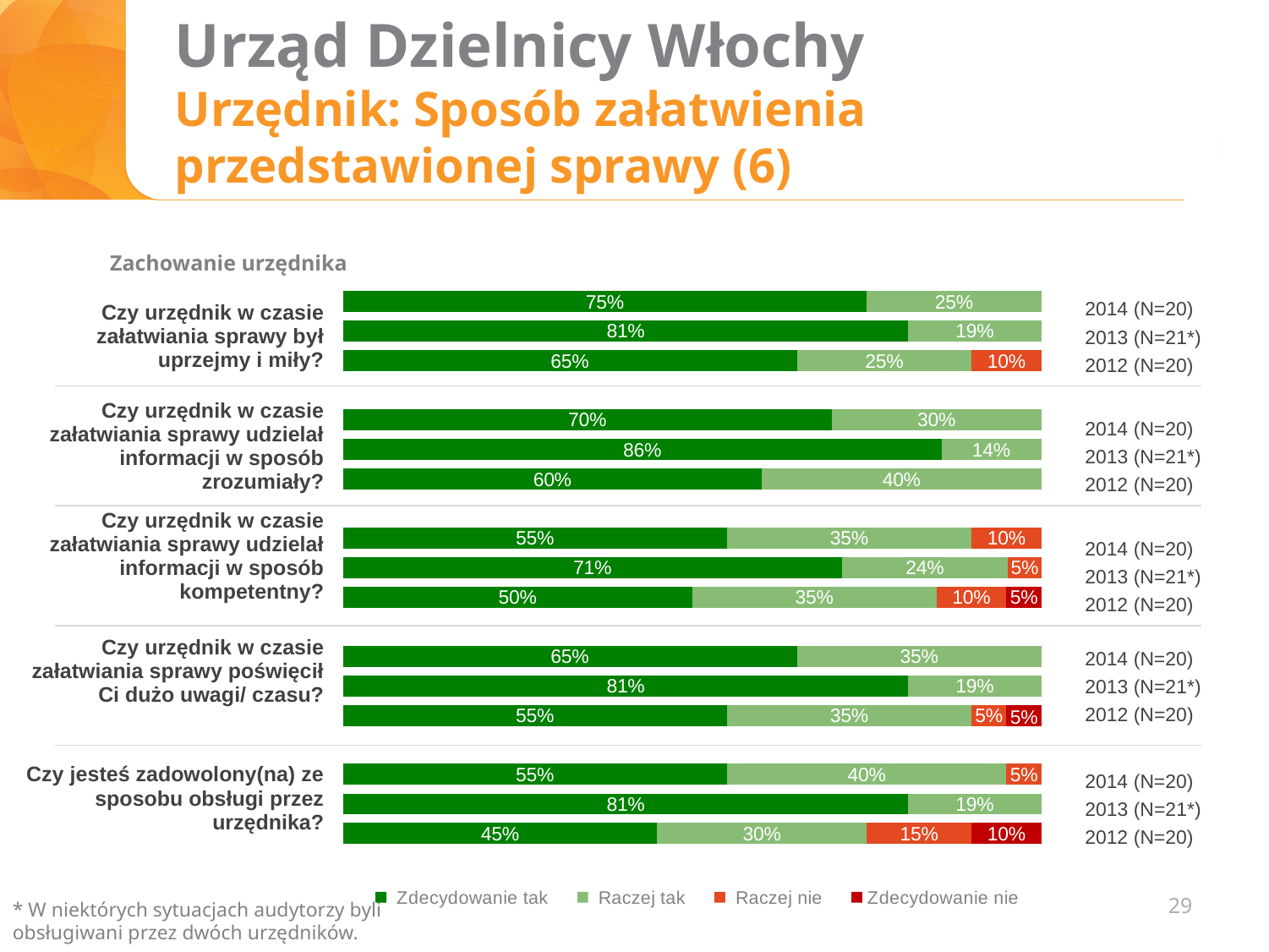
What percentage answered "Raczej nie" in 2012 to "Czy jesteś zadowolony(na) ze sposobu obsługi przez urzędnika?"? 15% How many answer categories does the legend list? 4 In 2014, which question had a larger "Zdecydowanie tak" share: "...udzielał informacji w sposób kompetentny?" or "...poświęcił Ci dużo uwagi/ czasu?"? Czy urzędnik w czasie załatwiania sprawy poświęcił Ci dużo uwagi/ czasu? For "Czy urzędnik w czasie załatwiania sprawy był uprzejmy i miły?", by how many percentage points did "Zdecydowanie tak" in 2013 exceed 2014? 6 percentage points For "Czy urzędnik w czasie załatwiania sprawy udzielał informacji w sposób zrozumiały?", which year had the highest share of "Zdecydowanie tak"? 2013 For "Czy jesteś zadowolony(na) ze sposobu obsługi przez urzędnika?", which year had the lowest share of "Zdecydowanie tak"? 2012 What percentage answered "Raczej tak" in 2012 to "Czy urzędnik w czasie załatwiania sprawy udzielał informacji w sposób zrozumiały?"? 40% What type of chart is shown on the slide? Stacked bar chart What percentage answered "Zdecydowanie tak" in 2014 to "Czy urzędnik w czasie załatwiania sprawy był uprzejmy i miły?"? 75% For "Czy urzędnik w czasie załatwiania sprawy udzielał informacji w sposób kompetentny?" in 2012, what is the combined share of "Raczej nie" and "Zdecydowanie nie"? 15% How many years are shown for each question? 3 What percentage answered "Zdecydowanie nie" in 2012 to "Czy jesteś zadowolony(na) ze sposobu obsługi przez urzędnika?"? 10%